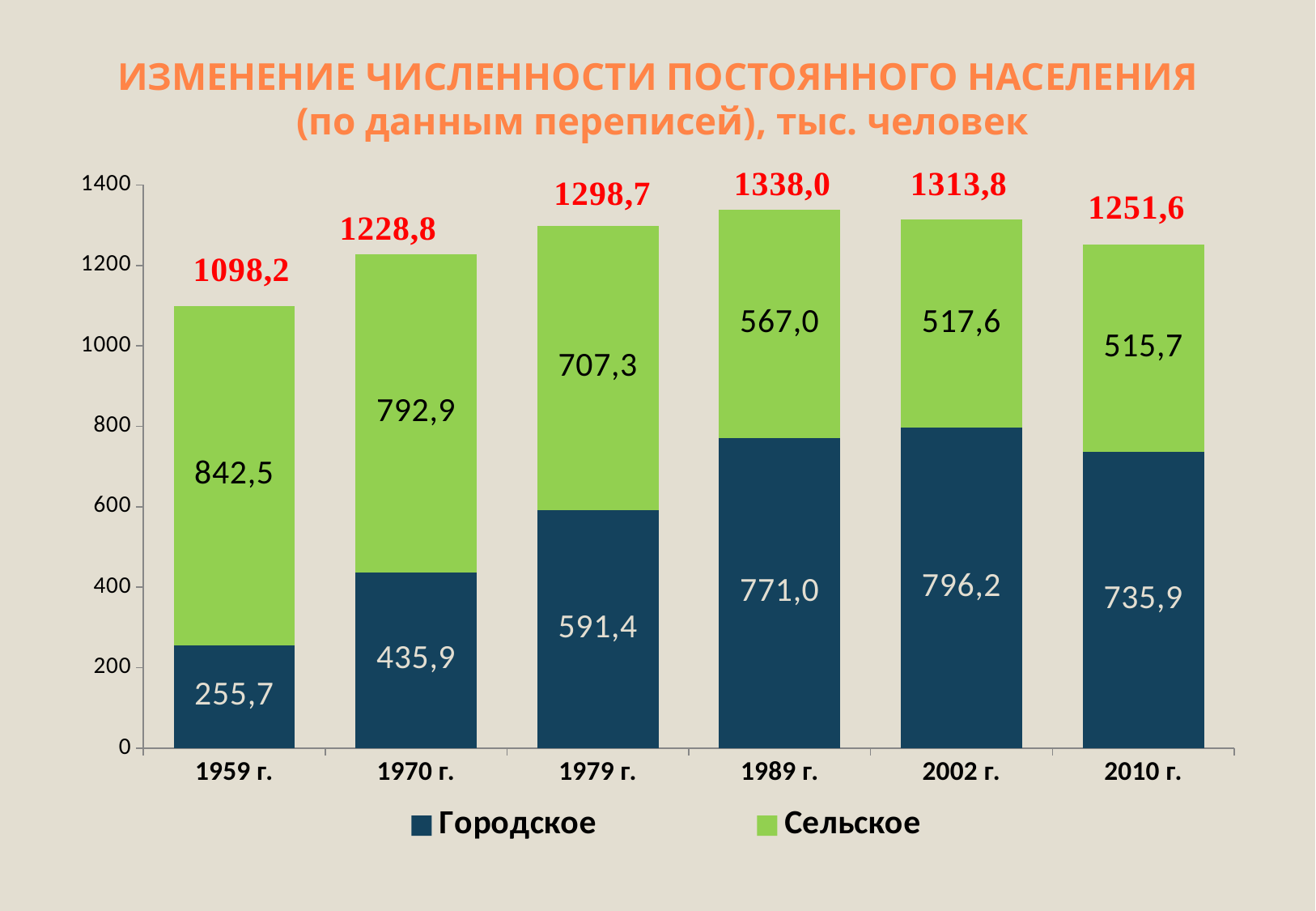
Which is larger in 1979 г., Городское or Сельское? Сельское In which year is the Городское value highest? 2002 г. In which year is the Сельское value lowest? 2010 г. What is the difference between the Сельское and Городское values in 1959 г.? 586,8 What is the value for Городское in 1989 г.? 771,0 Which year has the highest total population? 1989 г. How many years are shown on the x axis? 6 What is the value for Сельское in 1970 г.? 792,9 What kind of chart is shown on the slide? Stacked bar chart What is the total of the stacked bar for 2002 г.? 1313,8 Does the Городское value rise or fall from 1959 г. to 2002 г.? Rise How many series does the legend list? 2